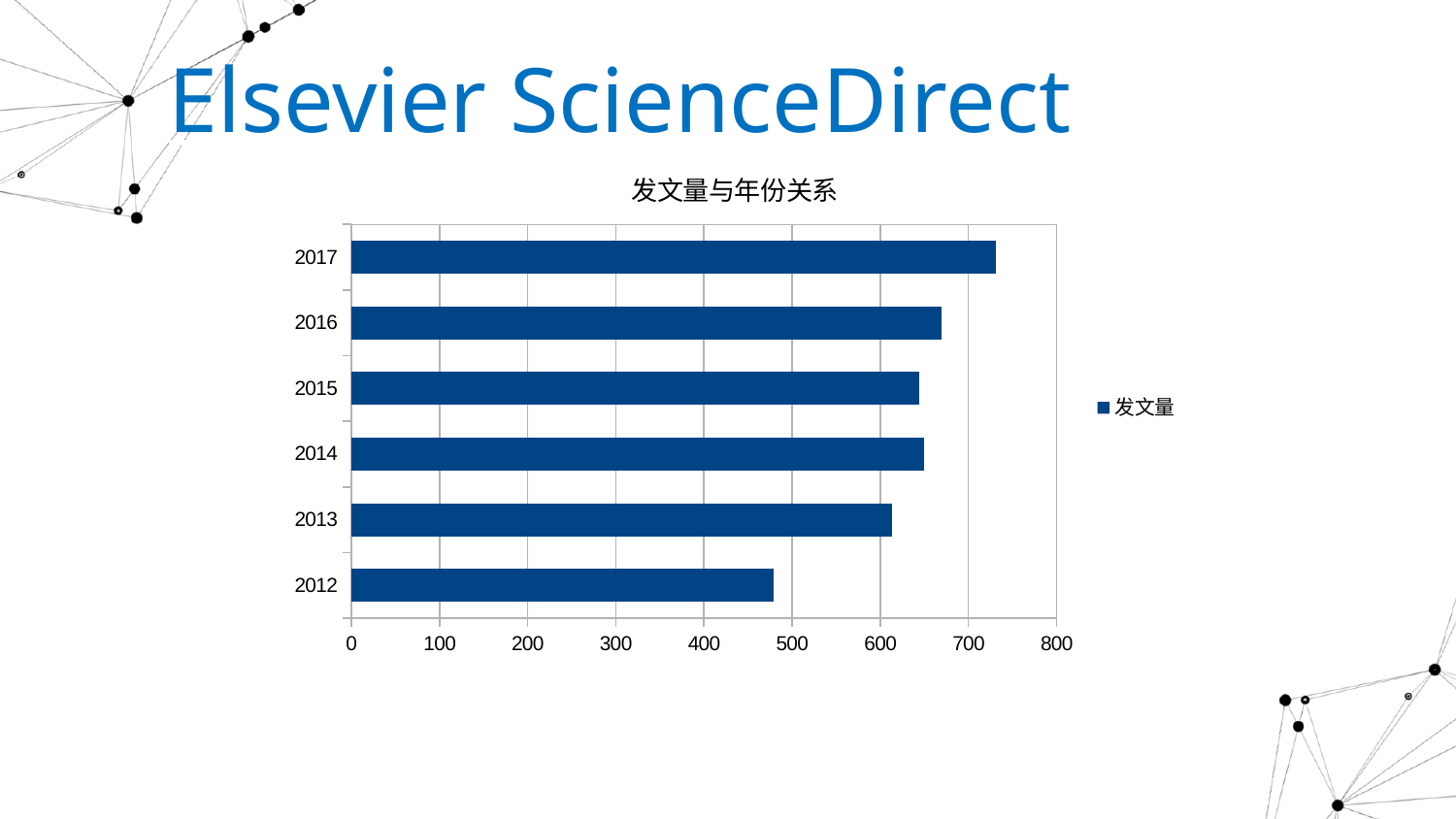
What type of chart is shown on the slide? bar chart Which year has the highest 发文量? 2017 What is the name of the series shown in the legend? 发文量 Which year has the lowest 发文量? 2012 Do the values generally rise or fall from 2012 to 2017? rise What is the title of the chart? 发文量与年份关系 How many years are plotted in the chart? 6 Is the value for 2017 greater or less than 700? greater Which year has a larger 发文量, 2016 or 2013? 2016 Is the value for 2013 greater or less than 600? greater Is the value for 2012 greater or less than 500? less How many series does the legend list? 1